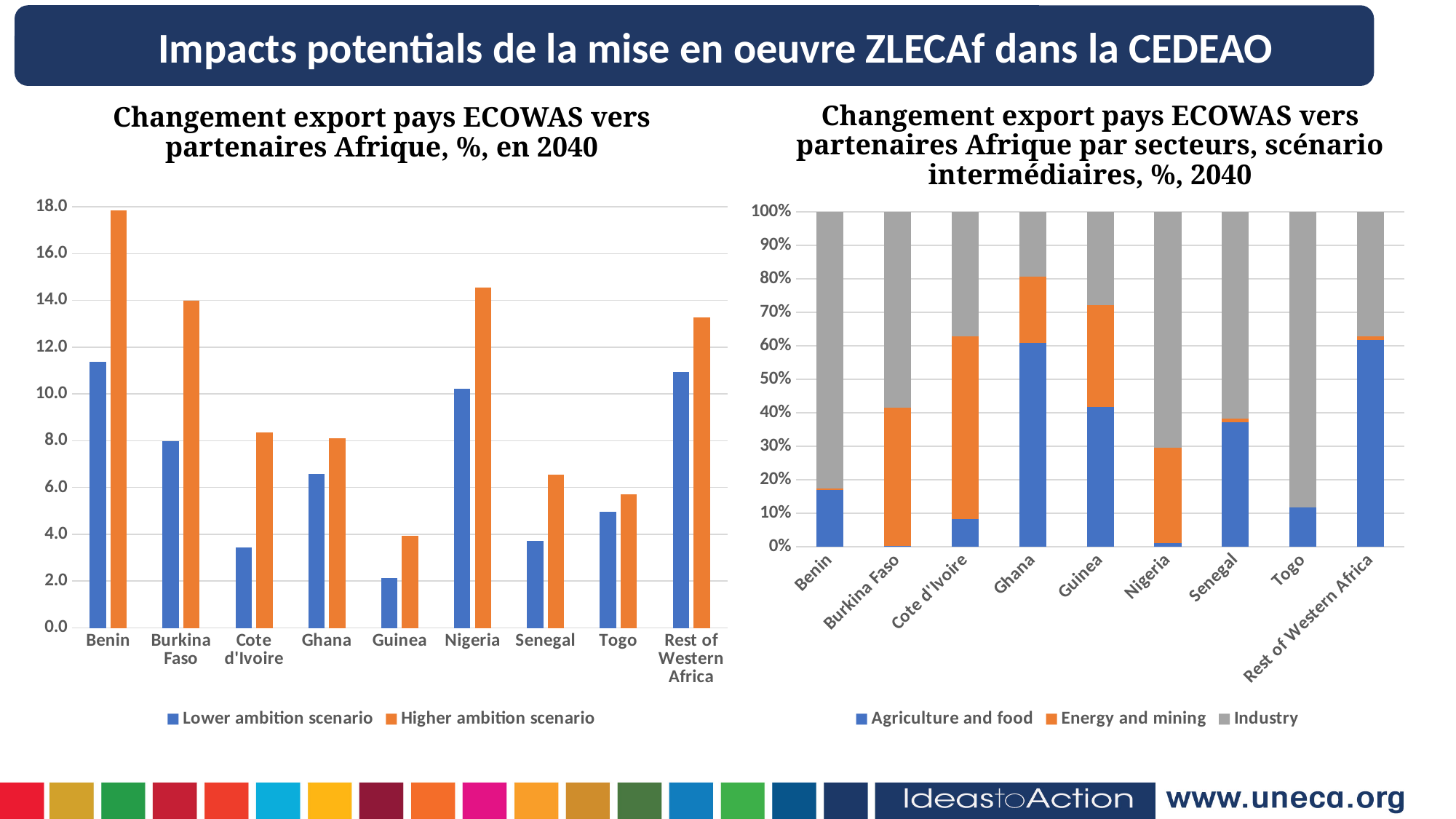
On the left chart, which country has the lowest value for the Lower ambition scenario? Guinea On the left chart, how many countries or regions are shown on the x axis? 9 On the left chart (Changement export pays ECOWAS vers partenaires Afrique, %, en 2040), what kind of chart is shown? Bar chart On the right chart (Changement export pays ECOWAS vers partenaires Afrique par secteurs), how many series does the legend list? 3 On the right chart, is the Agriculture and food share for Togo greater or less than 20%? less On the left chart, is the Lower ambition scenario value for Guinea greater or less than 4.0? less On the left chart, which is larger for Nigeria: the Lower ambition scenario or the Higher ambition scenario? Higher ambition scenario On the right chart, is the Agriculture and food share for Ghana greater or less than 50%? greater On the right chart, which sector is shown in grey in the legend? Industry On the left chart, how many series does the legend list? 2 On the left chart, which country has the highest value for the Higher ambition scenario? Benin